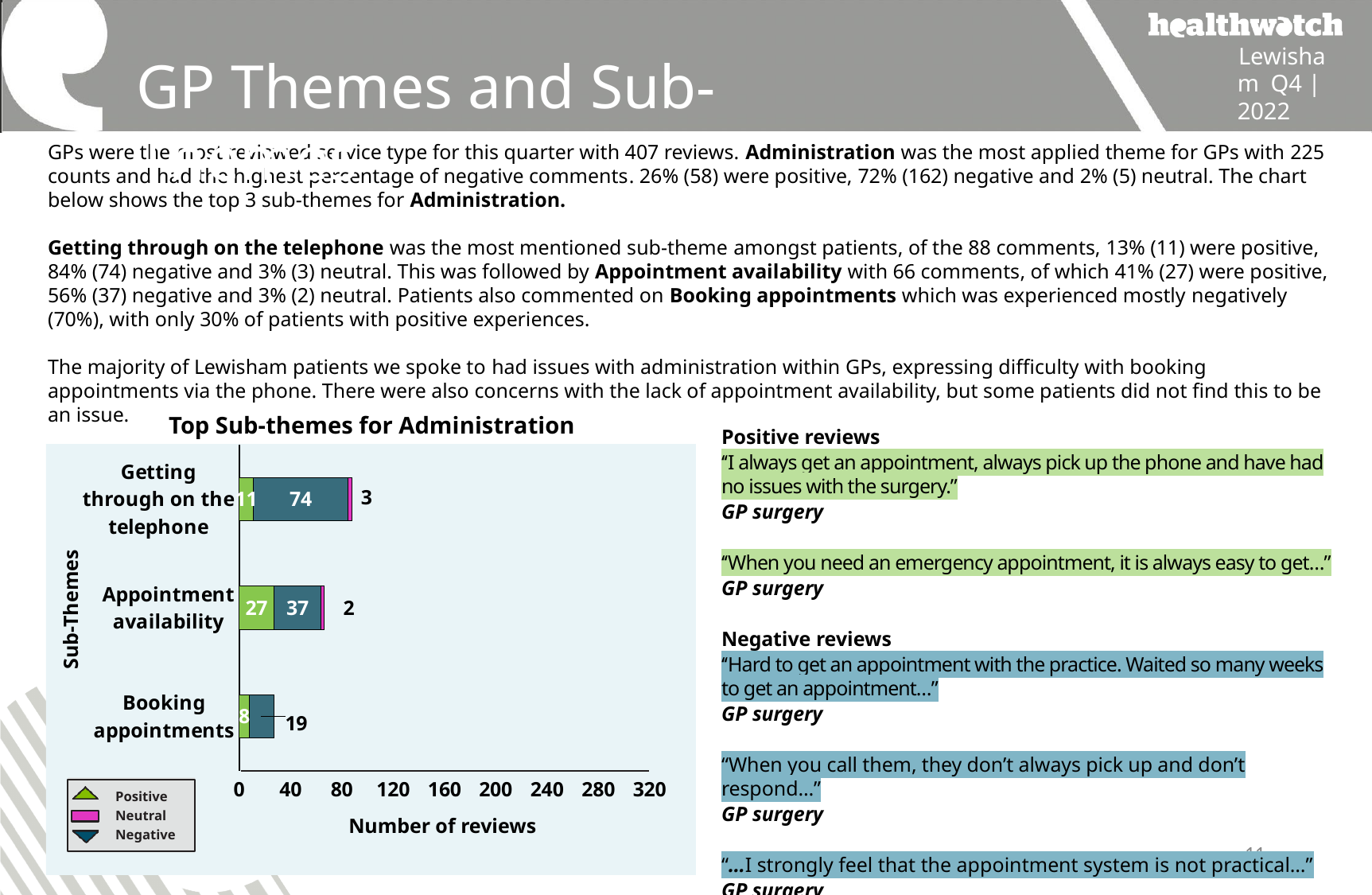
In the 'Top Sub-themes for Administration' chart, which sub-theme has the highest number of negative reviews? Getting through on the telephone In the 'Top Sub-themes for Administration' chart, how many neutral reviews are shown for 'Getting through on the telephone'? 3 In the 'Top Sub-themes for Administration' chart, which sub-theme has the lowest number of positive reviews? Booking appointments In the 'Top Sub-themes for Administration' chart, what is the total number of reviews for 'Getting through on the telephone'? 88 In the 'Top Sub-themes for Administration' chart, how many negative reviews are shown for 'Getting through on the telephone'? 74 In the 'Top Sub-themes for Administration' chart, what is the difference between the negative reviews for 'Getting through on the telephone' and 'Appointment availability'? 37 In the 'Top Sub-themes for Administration' chart, what is the total number of reviews for 'Appointment availability'? 66 What kind of chart is 'Top Sub-themes for Administration'? Stacked bar chart In the 'Top Sub-themes for Administration' chart, how many sub-themes are plotted? 3 How many series does the legend of the 'Top Sub-themes for Administration' chart list? 3 In the 'Top Sub-themes for Administration' chart, how many positive reviews are shown for 'Appointment availability'? 27 In the 'Top Sub-themes for Administration' chart, how many negative reviews are shown for 'Booking appointments'? 19